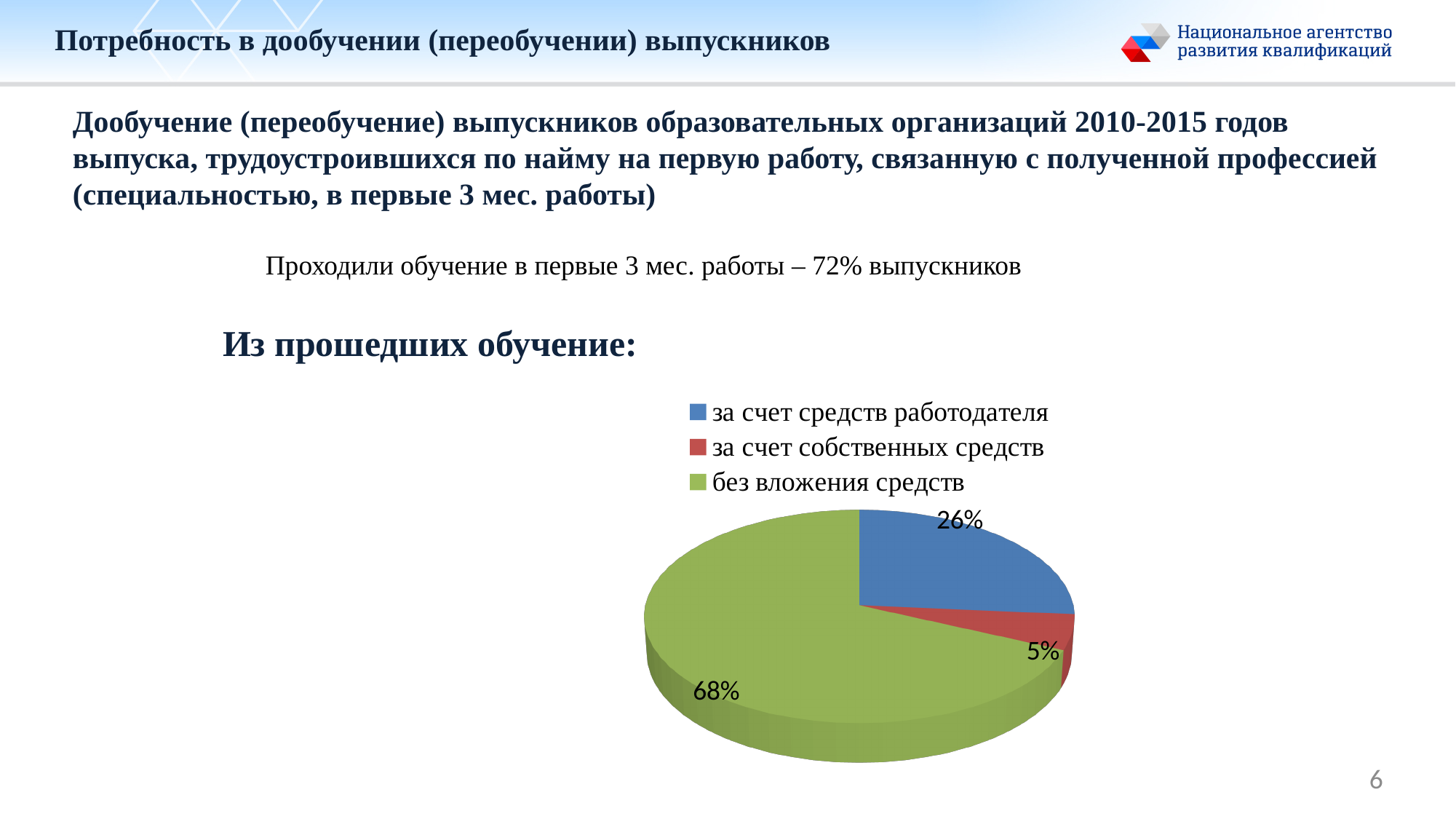
What colour is the slice for 'без вложения средств'? green Which category has the largest slice of the pie? без вложения средств Which is larger: the slice for 'за счет средств работодателя' or the slice for 'за счет собственных средств'? за счет средств работодателя How many entries does the legend list? 3 What is the difference in percentage points between 'без вложения средств' and 'за счет средств работодателя'? 42 What colour is the slice for 'за счет собственных средств'? red What share of the pie is 'за счет средств работодателя'? 26% How many slices does the pie chart have? 3 What share of the pie is 'за счет собственных средств'? 5% What kind of chart is shown on the slide? pie chart What share of the pie is 'без вложения средств'? 68% Which category has the smallest slice of the pie? за счет собственных средств